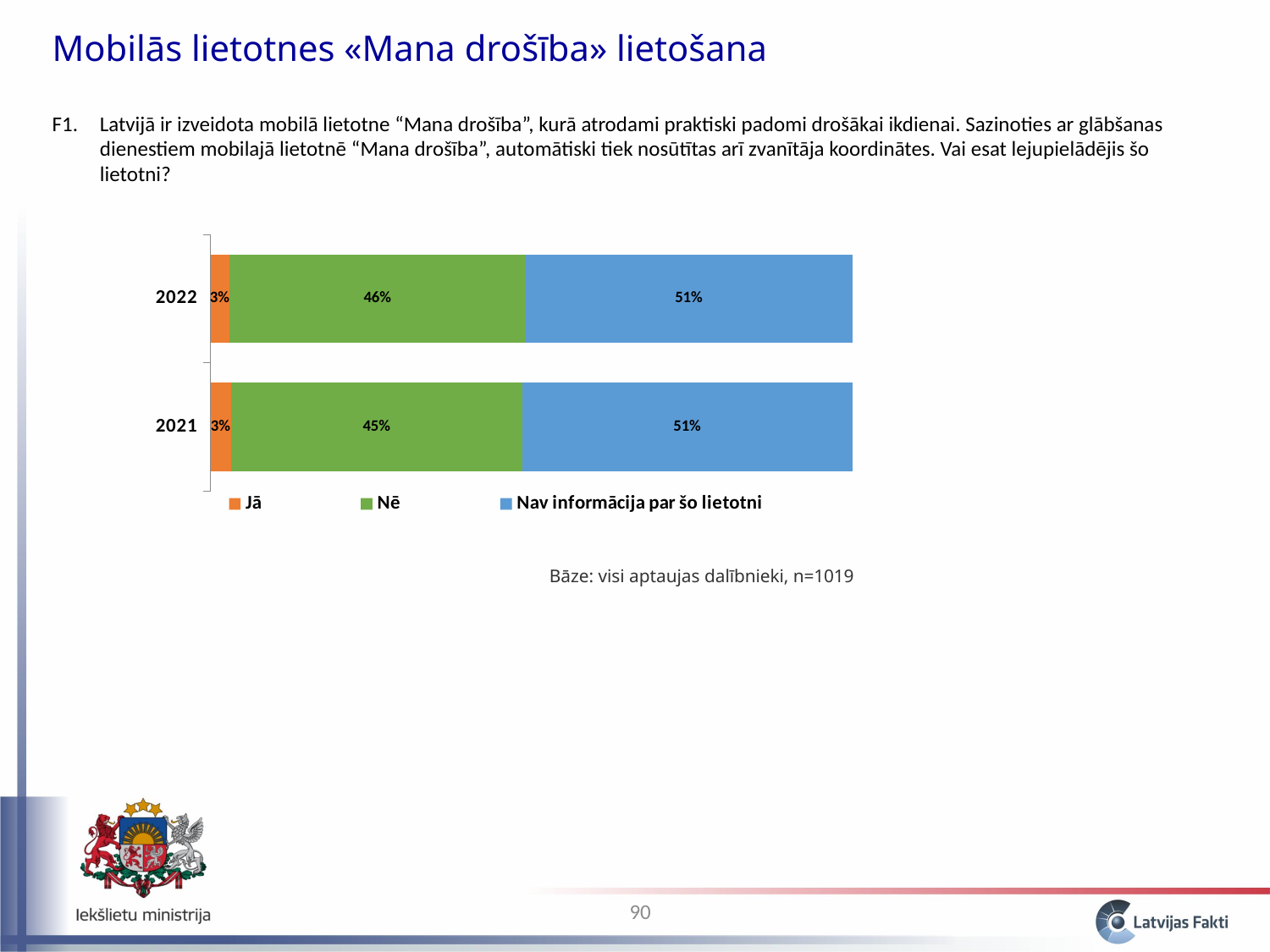
Which response has the smallest share in 2022? Jā What percentage answered "Nē" in 2021? 45% How many series does the legend list? 3 Which response has the largest share in 2021? Nav informācija par šo lietotni Is the "Nē" share larger in 2022 or in 2021? 2022 What colour represents the "Jā" series in the chart? Orange How many years are shown in the chart? 2 What percentage answered "Nav informācija par šo lietotni" in 2022? 51% What type of chart is shown on the slide? Stacked bar chart What percentage answered "Nē" in 2022? 46% What is the difference between the "Nē" share in 2022 and in 2021? 1% What percentage answered "Jā" in 2022? 3%